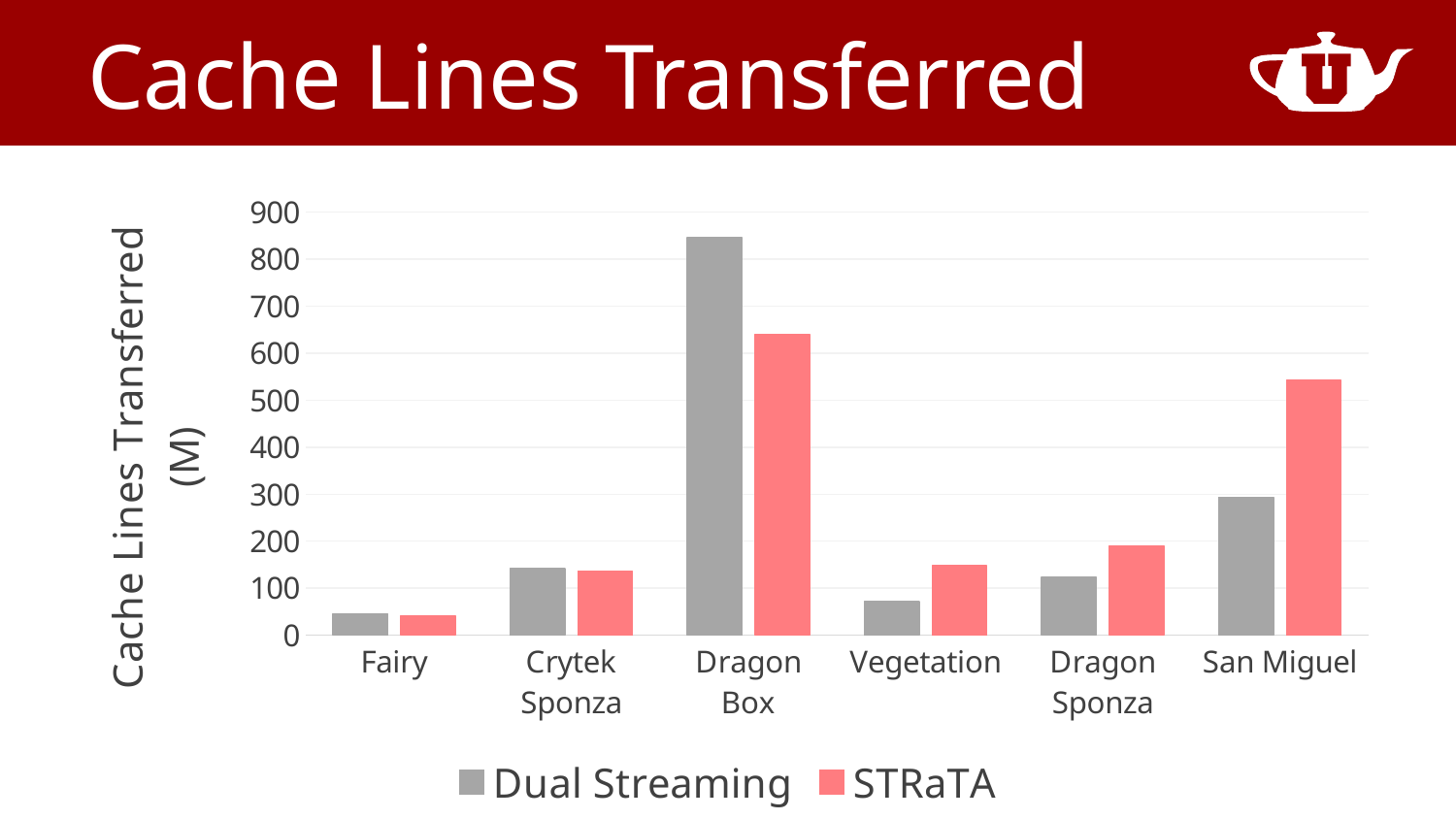
Which scene has the lowest STRaTA value? Fairy Is the STRaTA value for San Miguel greater or less than 500? greater What is the label of the y axis? Cache Lines Transferred (M) Is the Dual Streaming value for Vegetation greater or less than 100? less How many scenes (categories) are shown on the x axis? 6 How many series does the legend list? 2 Which scene has the highest Dual Streaming value? Dragon Box For San Miguel, which series has the larger value, Dual Streaming or STRaTA? STRaTA Is the Dual Streaming value for Dragon Box greater or less than 800? greater What kind of chart is shown on the slide? bar chart For Dragon Box, which series has the larger value, Dual Streaming or STRaTA? Dual Streaming Which scene has the highest STRaTA value? Dragon Box